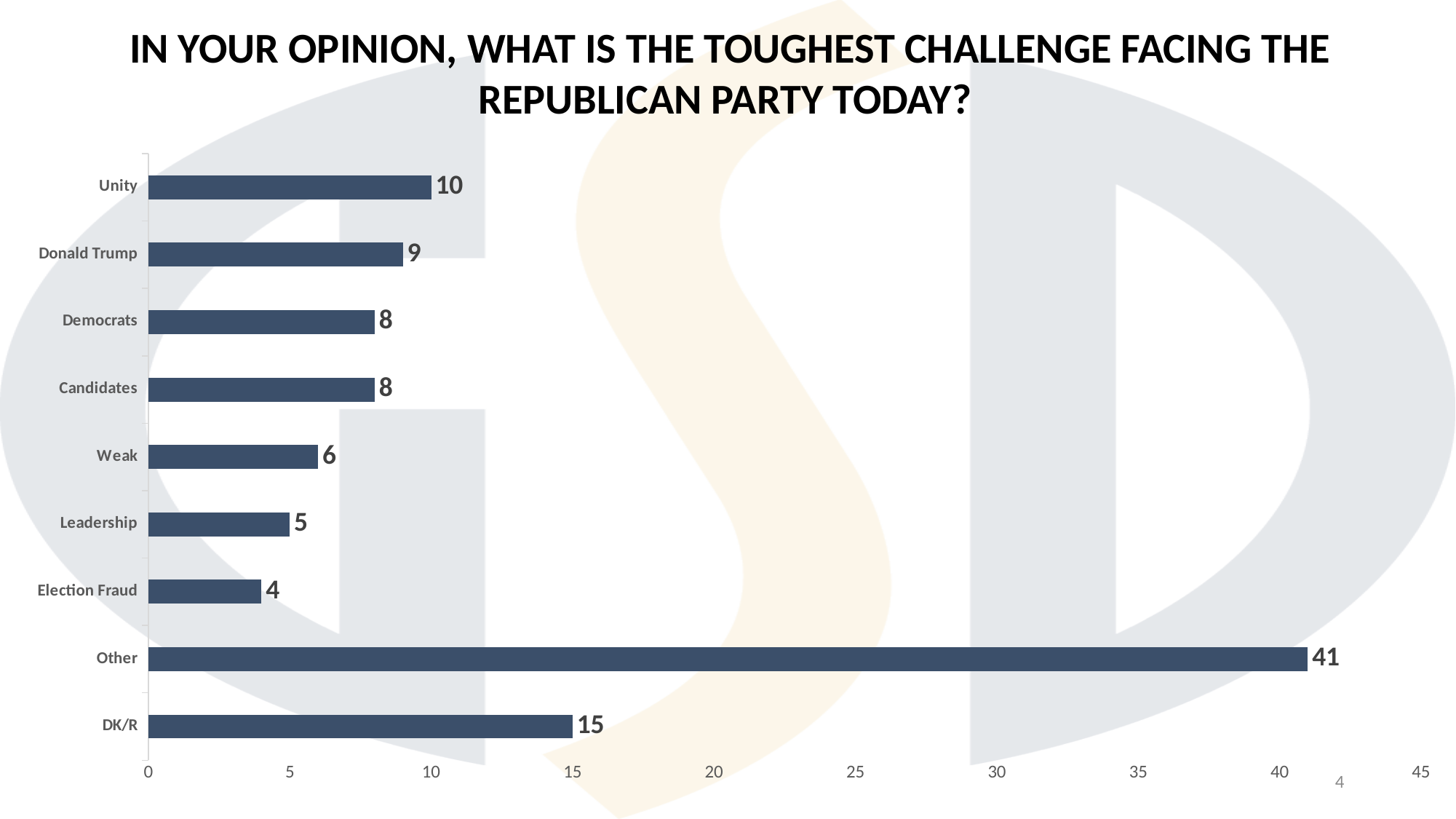
What is the value for Unity? 10 Is the value for Other greater or less than 40? greater What is the value for Donald Trump? 9 Which is larger, the value for Weak or the value for Leadership? Weak What is the difference between the values for Other and DK/R? 26 Which category has the highest value? Other What is the value for Election Fraud? 4 What is the value for DK/R? 15 Which category has the lowest value? Election Fraud How many categories are shown in the chart? 9 What is the difference between the values for Unity and Democrats? 2 What kind of chart is shown on the slide? bar chart